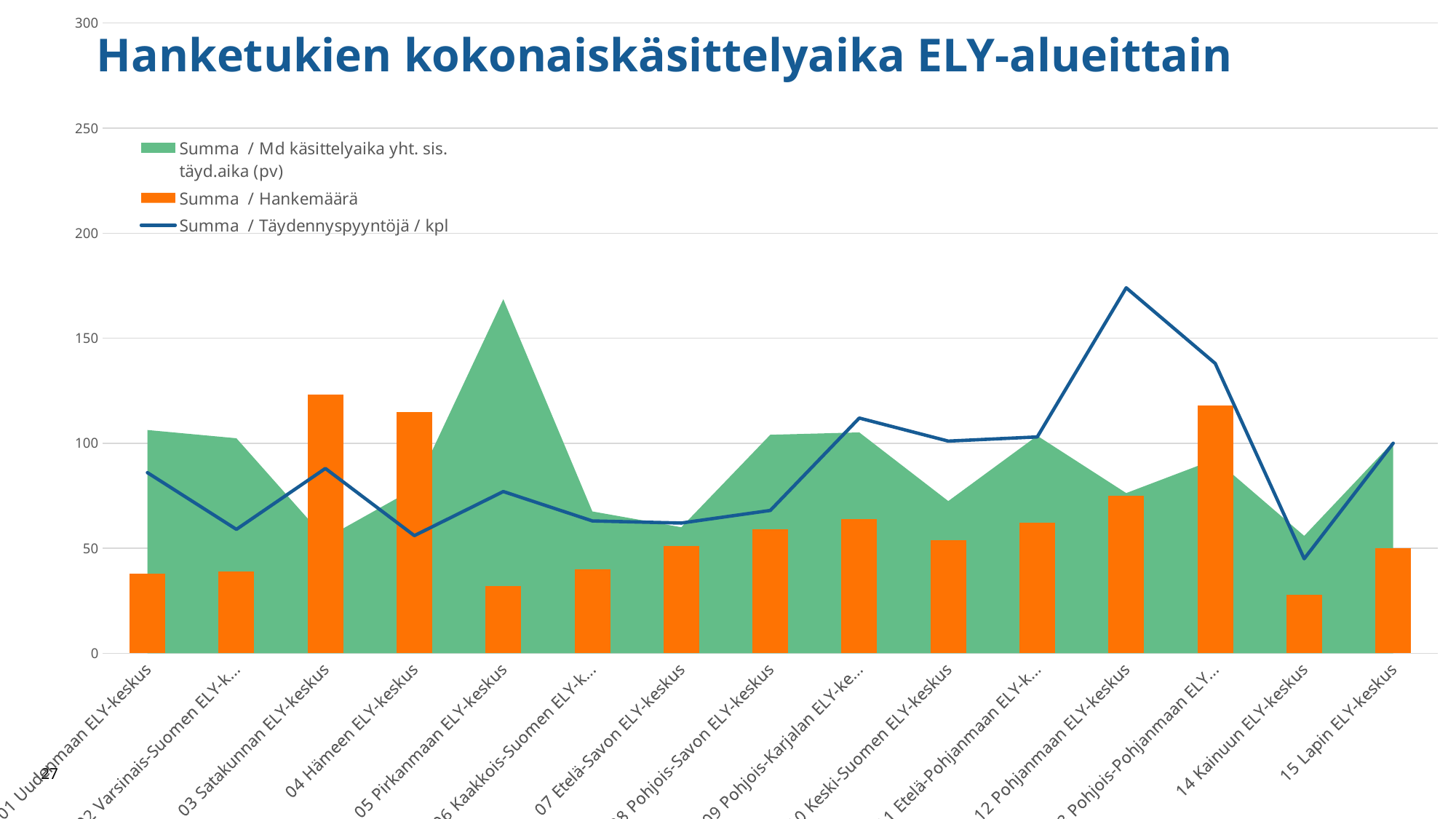
Which category has the lowest value for the line series Summa / Täydennyspyyntöjä / kpl? 14 Kainuun ELY-keskus Which has the larger Summa / Hankemäärä bar, 03 Satakunnan ELY-keskus or 01 Uudenmaan ELY-keskus? 03 Satakunnan ELY-keskus Is the Summa / Täydennyspyyntöjä / kpl line value for 12 Pohjanmaan ELY-keskus greater or less than 150? greater What is the title of the chart? Hanketukien kokonaiskäsittelyaika ELY-alueittain How many ELY-keskus categories are shown on the x axis? 15 Which category has the highest value for the green area series Summa / Md käsittelyaika yht. sis. täyd.aika (pv)? 05 Pirkanmaan ELY-keskus Is the Summa / Täydennyspyyntöjä / kpl line value for 14 Kainuun ELY-keskus greater or less than 100? less How many series does the legend list? 3 Is the Summa / Hankemäärä bar for 01 Uudenmaan ELY-keskus greater or less than 50? less Which category has the highest value for the line series Summa / Täydennyspyyntöjä / kpl? 12 Pohjanmaan ELY-keskus What kind of chart is shown on the slide? A combination chart with an area series, a bar series and a line series